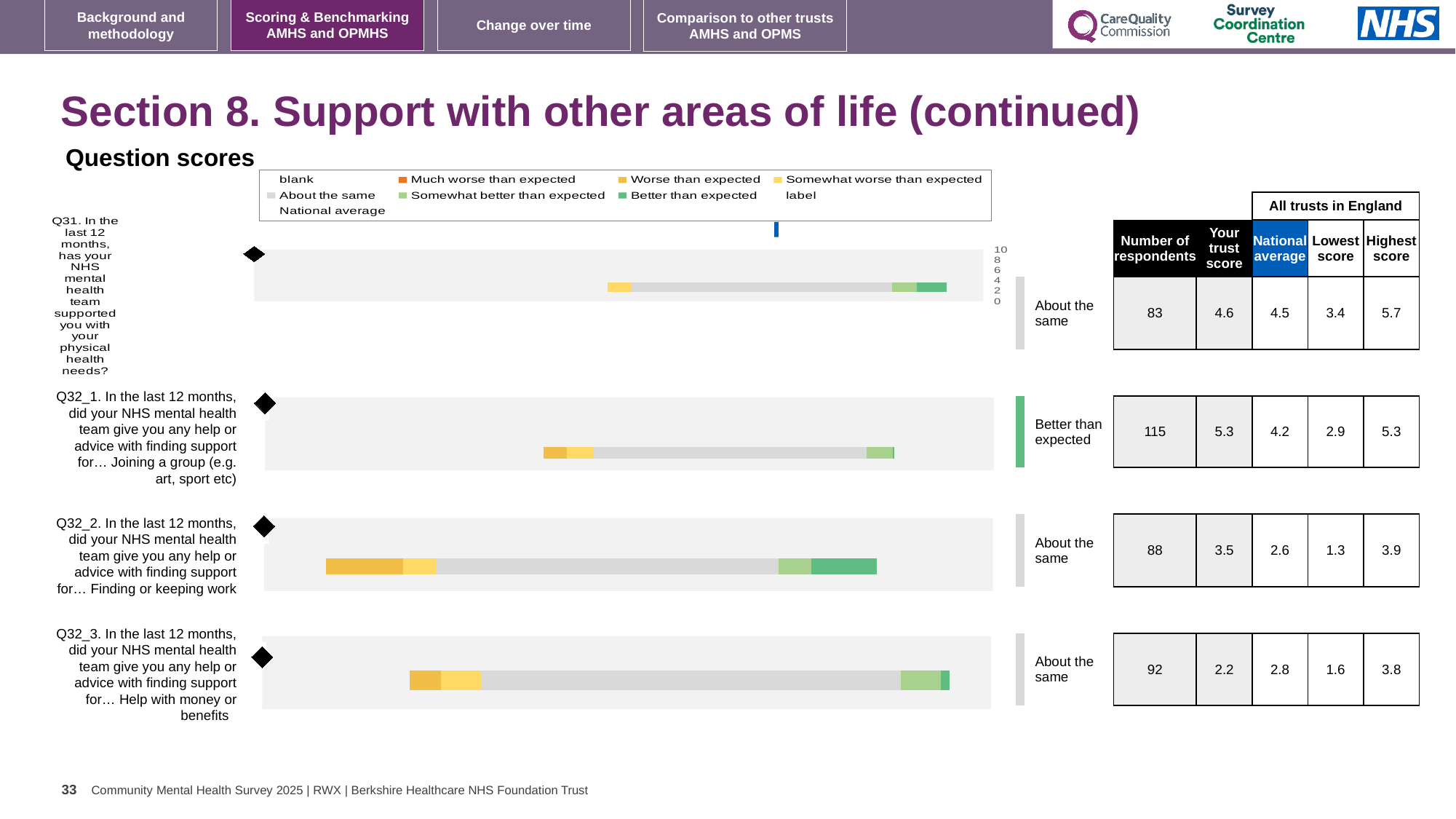
How many respondents are listed for Q31 (support with physical health needs)? 83 What is the national average score for Q32_2 (finding or keeping work)? 2.6 What colour represents 'Better than expected' in the legend? Green For Q32_2 (finding or keeping work), which is larger: the trust score or the national average? The trust score (3.5) How many questions (chart rows) are shown on the slide? 4 What kind of chart is used to show the question scores on this slide? Bar chart What is the 'Your trust score' value for Q32_1 (help with joining a group)? 5.3 How many entries does the legend above the question score charts list? 9 What benchmark label is shown next to the Q32_1 chart row? Better than expected Which question has the highest 'Your trust score'? Q32_1 (Joining a group) Which question has the lowest 'Your trust score'? Q32_3 (Help with money or benefits) For Q32_3 (help with money or benefits), what is the difference between the highest score and the lowest score across all trusts in England? 2.2